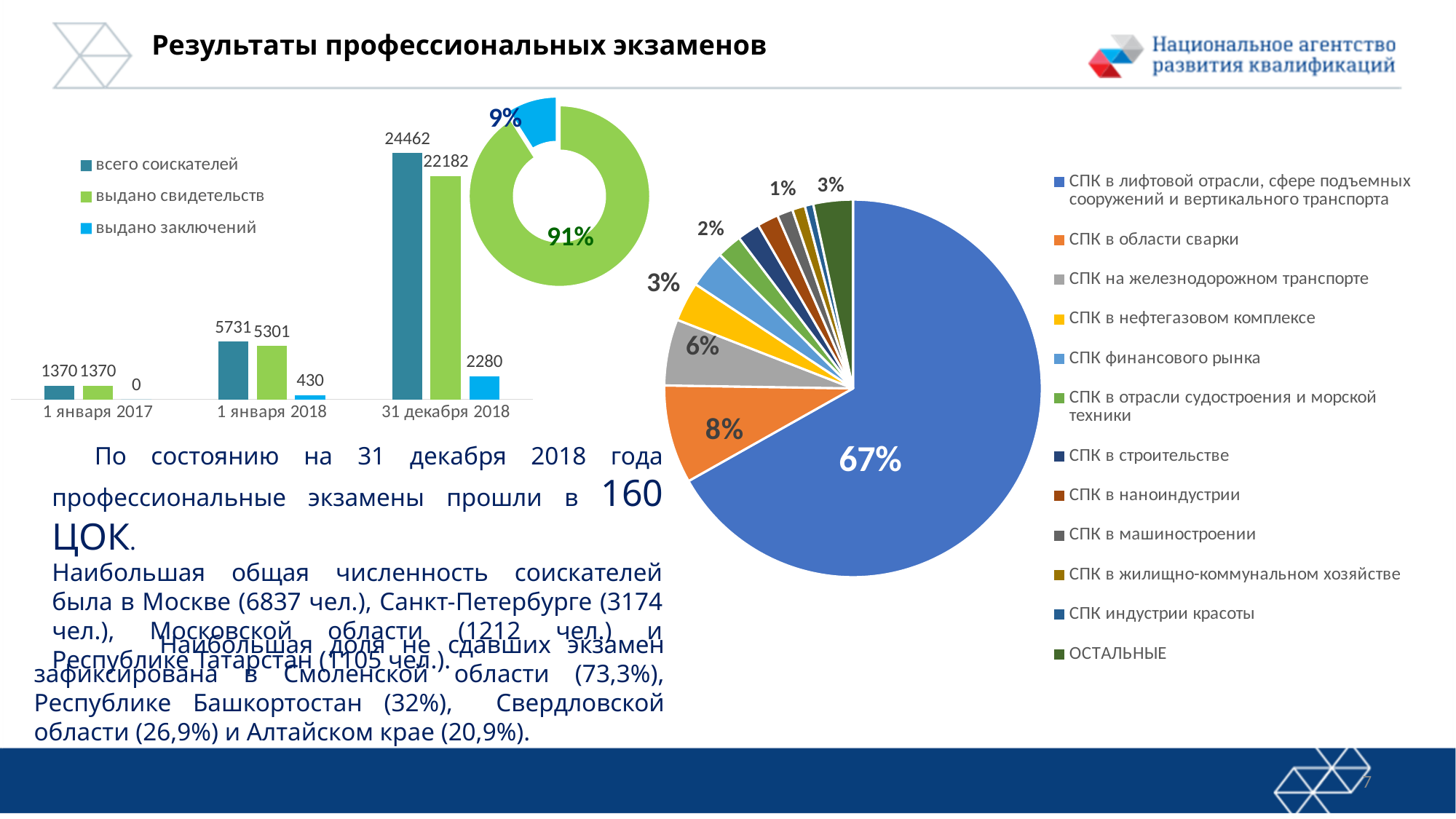
On the pie chart on the right, what share does 'СПК в лифтовой отрасли, сфере подъемных сооружений и вертикального транспорта' have? 67% On the pie chart on the right, what share does 'СПК в области сварки' have? 8% On the bar chart on the left, how many series does the legend list? 3 On the small donut chart in the middle of the slide, what share does the green segment have? 91% On the pie chart on the right, how many entries does the legend list? 12 On the bar chart on the left, what is the value for 'выдано свидетельств' on 1 января 2018? 5301 On the bar chart on the left, what is the difference between 'всего соискателей' and 'выдано свидетельств' on 31 декабря 2018? 2280 On the bar chart on the left, how many date categories are shown on the x axis? 3 On the bar chart on the left, what is the value for 'всего соискателей' on 31 декабря 2018? 24462 On the bar chart on the left, what is the value for 'выдано заключений' on 1 января 2017? 0 What kind of chart is the chart on the left of the slide? bar chart On the bar chart on the left, does the value for 'всего соискателей' rise or fall from 1 января 2017 to 31 декабря 2018? rise